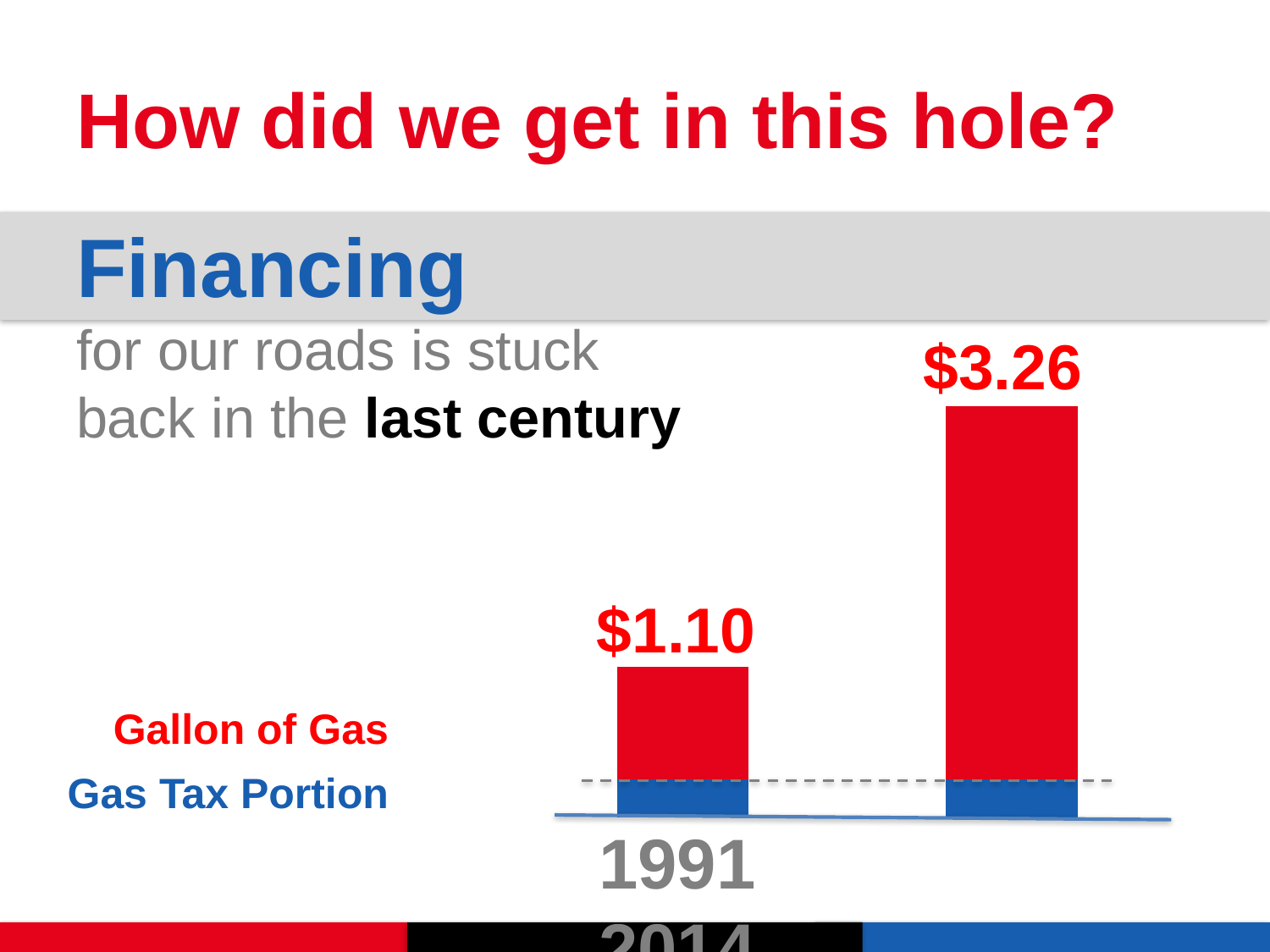
How many bars are plotted in the chart? 2 What is the value shown for the right-hand (2014) bar? $3.26 Is the value for 1991 larger or smaller than the value for the right-hand bar? smaller What is the difference between the $3.26 bar and the $1.10 bar? $2.16 What kind of chart is shown on the slide? bar chart Which bar has the lowest value? 1991 Do the bar values rise or fall from the left bar to the right bar? rise Which series is shown in red? Gallon of Gas What colour represents the Gas Tax Portion series? blue What is the value shown for the 1991 bar? $1.10 Which bar is the tallest, the 1991 bar or the right-hand bar? the right-hand (2014) bar